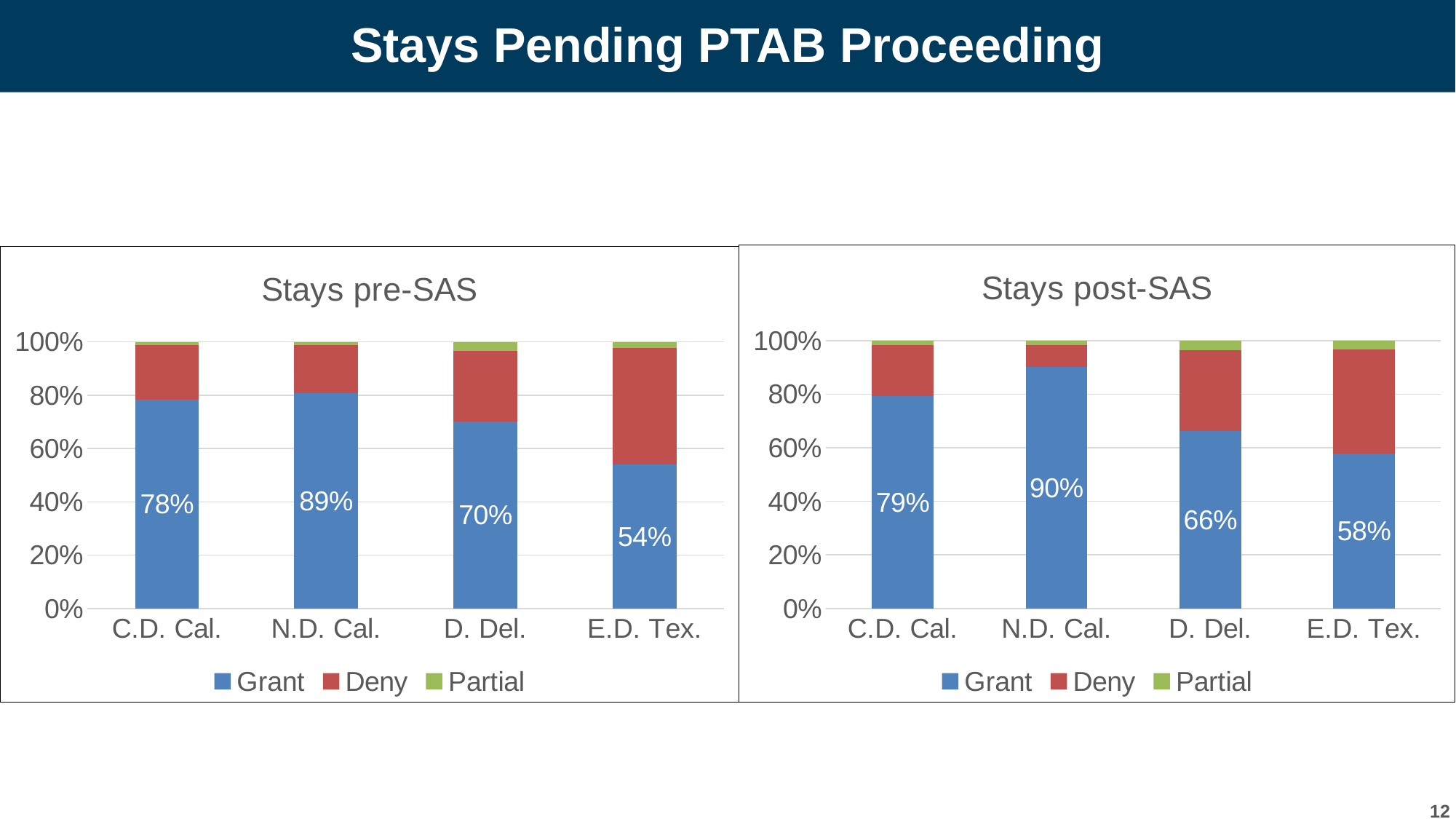
In the 'Stays pre-SAS' chart, what is the Grant percentage for C.D. Cal.? 78% In the 'Stays pre-SAS' chart, which court has the highest Grant percentage? N.D. Cal. In the 'Stays post-SAS' chart, which has a larger Grant percentage, C.D. Cal. or D. Del.? C.D. Cal. In the 'Stays pre-SAS' chart, which colour represents the Deny series? Red In the 'Stays post-SAS' chart, what is the Grant percentage for D. Del.? 66% In the 'Stays post-SAS' chart, what is the Grant percentage for N.D. Cal.? 90% In the 'Stays post-SAS' chart, which court has the lowest Grant percentage? E.D. Tex. In the 'Stays pre-SAS' chart, what is the difference between the Grant percentages for N.D. Cal. and E.D. Tex.? 35% In the 'Stays pre-SAS' chart, is the Grant value for E.D. Tex. greater or less than 60%? less How many courts are shown on the x axis of the 'Stays post-SAS' chart? 4 How many series does the legend of the 'Stays pre-SAS' chart list? 3 What kind of chart is the 'Stays post-SAS' chart? Stacked bar chart